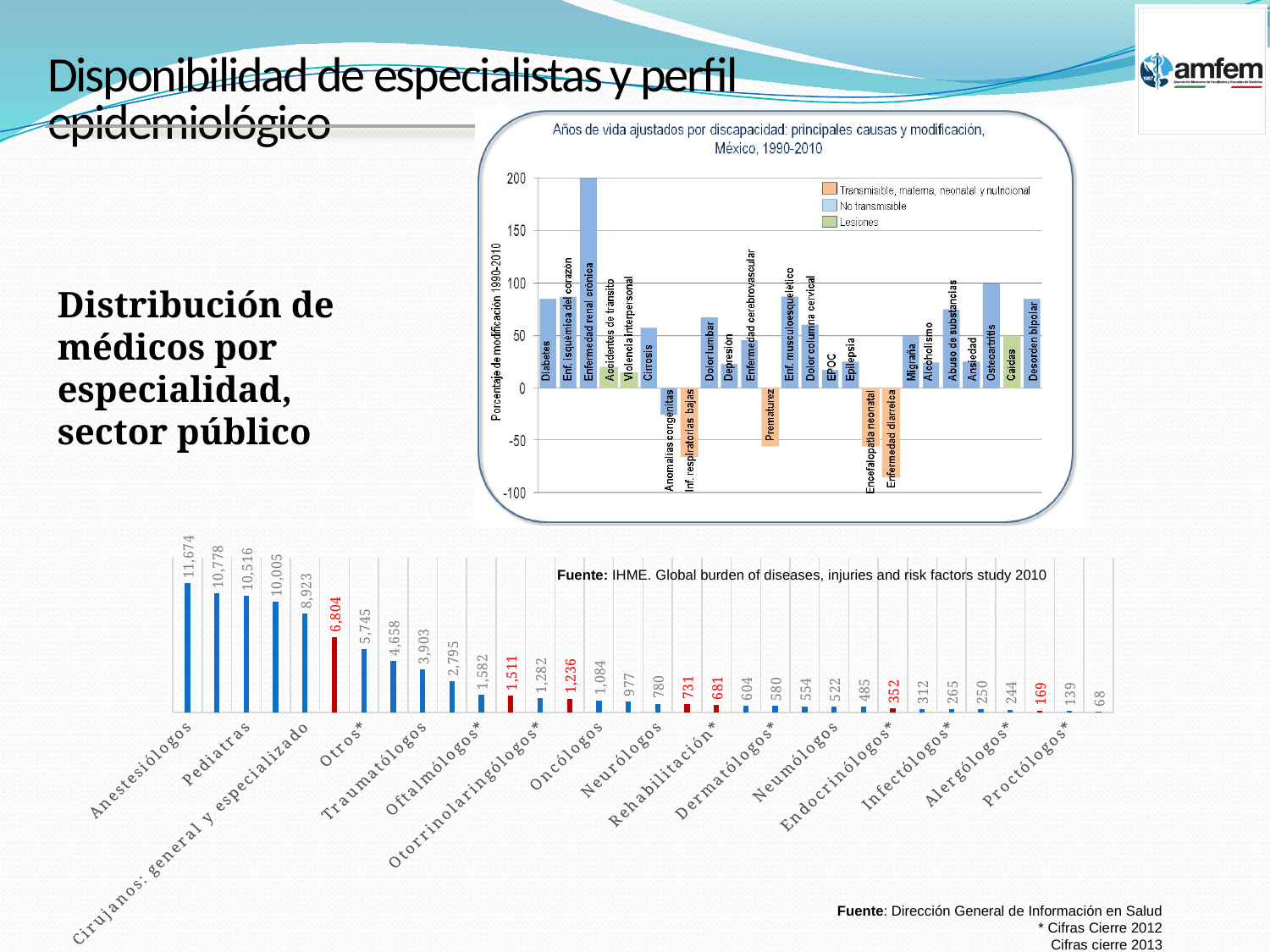
In the top-right chart (Años de vida ajustados por discapacidad), which colour does the legend use for Lesiones? green In the bottom chart (Distribución de médicos por especialidad, sector público), what is the smallest value shown on any bar? 68 In the top-right chart (Años de vida ajustados por discapacidad), which cause has the highest percentage of modification? Enfermedad renal crónica In the top-right chart (Años de vida ajustados por discapacidad), how many series does the legend list? 3 In the top-right chart (Años de vida ajustados por discapacidad), is the value for Diabetes greater or less than 50? greater In the bottom chart (Distribución de médicos por especialidad, sector público), what is the difference between the largest value (11,674) and the smallest value (68)? 11,606 In the bottom chart (Distribución de médicos por especialidad, sector público), which specialty has the highest number of physicians? Anestesiólogos What kind of chart is the bottom chart (Distribución de médicos por especialidad, sector público)? bar chart In the bottom chart (Distribución de médicos por especialidad, sector público), how many bars are plotted? 32 In the top-right chart (Años de vida ajustados por discapacidad), is the value for Epilepsia greater or less than 50? less In the bottom chart (Distribución de médicos por especialidad, sector público), what is the value for Anestesiólogos? 11,674 In the bottom chart (Distribución de médicos por especialidad, sector público), do the values rise or fall from left to right? fall